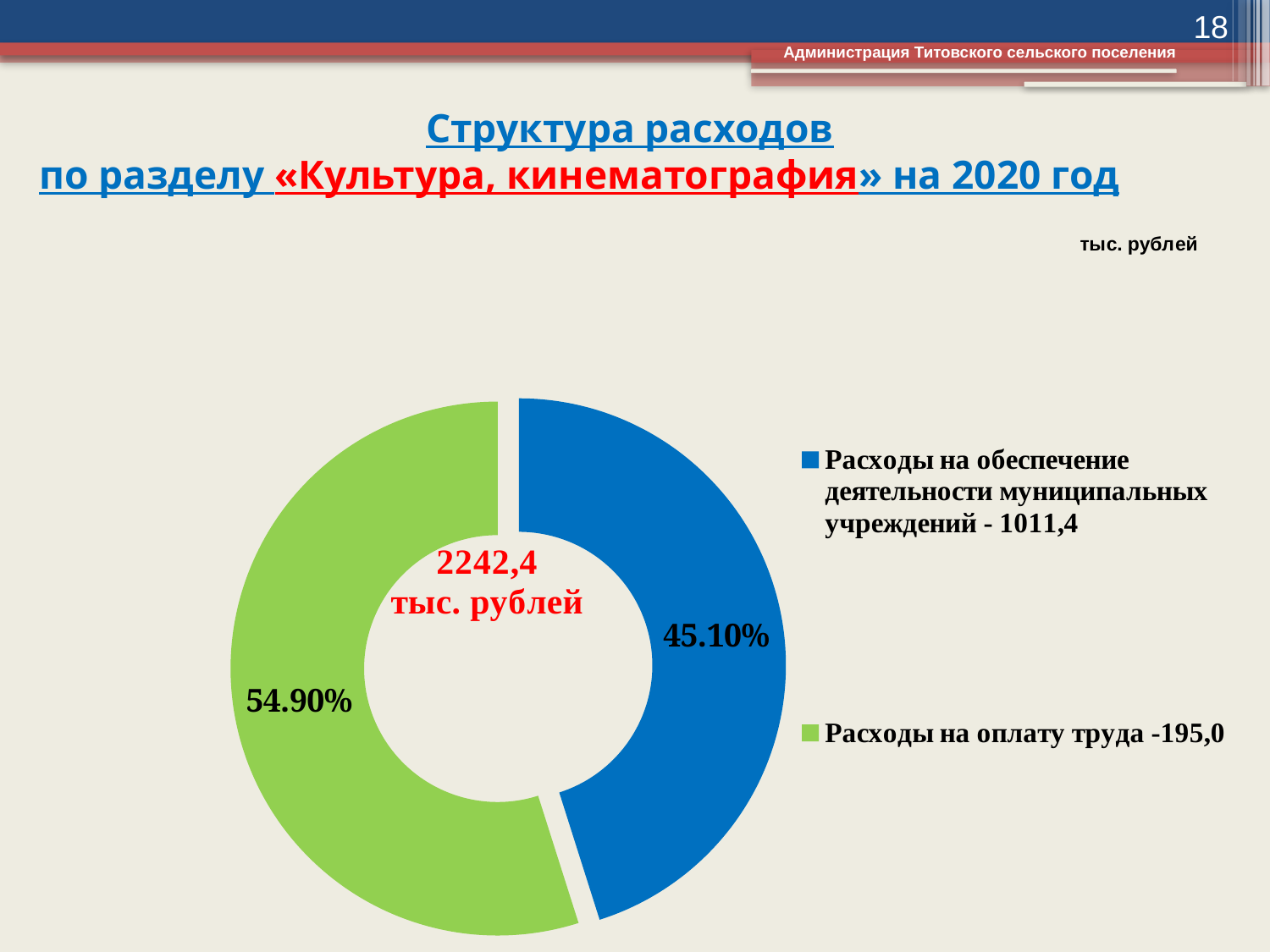
What total value is printed in the centre of the doughnut chart? 2242,4 тыс. рублей How many slices does the pie chart have? 2 What share of the pie does the slice "Расходы на оплату труда -195,0" represent? 54.90% How many entries does the legend list? 2 What share of the pie does the slice "Расходы на обеспечение деятельности муниципальных учреждений - 1011,4" represent? 45.10% Is the share for "Расходы на оплату труда" greater or less than 50%? greater Which slice of the pie is the smallest? Расходы на обеспечение деятельности муниципальных учреждений - 1011,4 Which slice of the pie is the largest? Расходы на оплату труда -195,0 What colour is the slice for "Расходы на обеспечение деятельности муниципальных учреждений - 1011,4"? Blue Which slice is larger: "Расходы на оплату труда" or "Расходы на обеспечение деятельности муниципальных учреждений"? Расходы на оплату труда What kind of chart is shown on the slide? Pie chart (doughnut) What is the difference in percentage points between the two slices of the pie? 9.80%